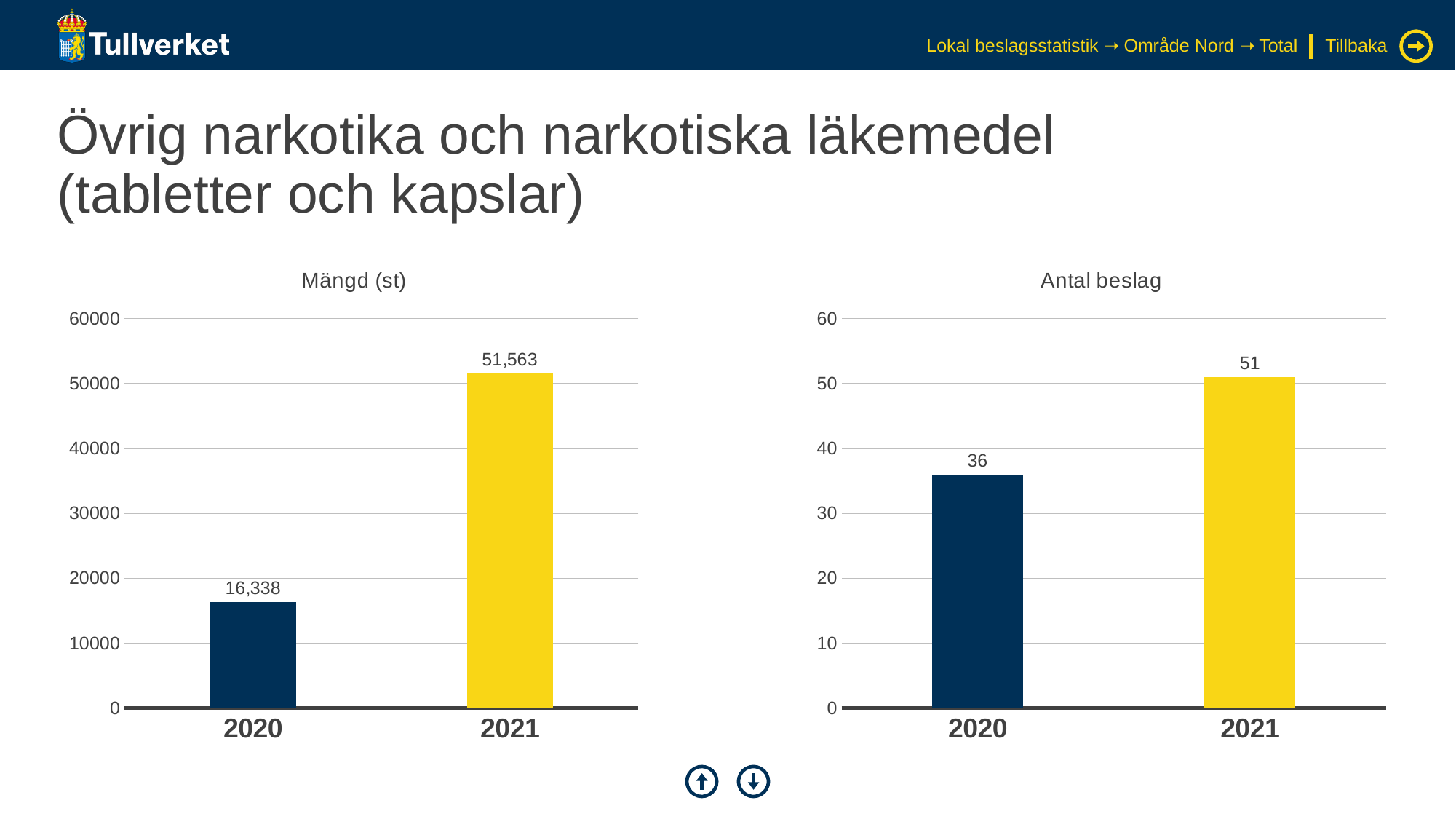
In the "Mängd (st)" chart, what is the value for 2020? 16,338 In the "Antal beslag" chart, what is the difference between the 2021 and 2020 values? 15 What kind of chart is the "Mängd (st)" chart? bar chart In the "Mängd (st)" chart, is the value for 2020 greater or less than 20000? less In the "Mängd (st)" chart, what is the difference between the 2021 and 2020 values? 35,225 In the "Antal beslag" chart, what is the value for 2021? 51 How many categories are shown on the x axis of the "Antal beslag" chart? 2 In the "Mängd (st)" chart, which year has the highest value? 2021 In the "Mängd (st)" chart, what is the value for 2021? 51,563 In the "Antal beslag" chart, which year has the lowest value? 2020 In the "Antal beslag" chart, do the values rise or fall from 2020 to 2021? rise In the "Antal beslag" chart, what is the value for 2020? 36